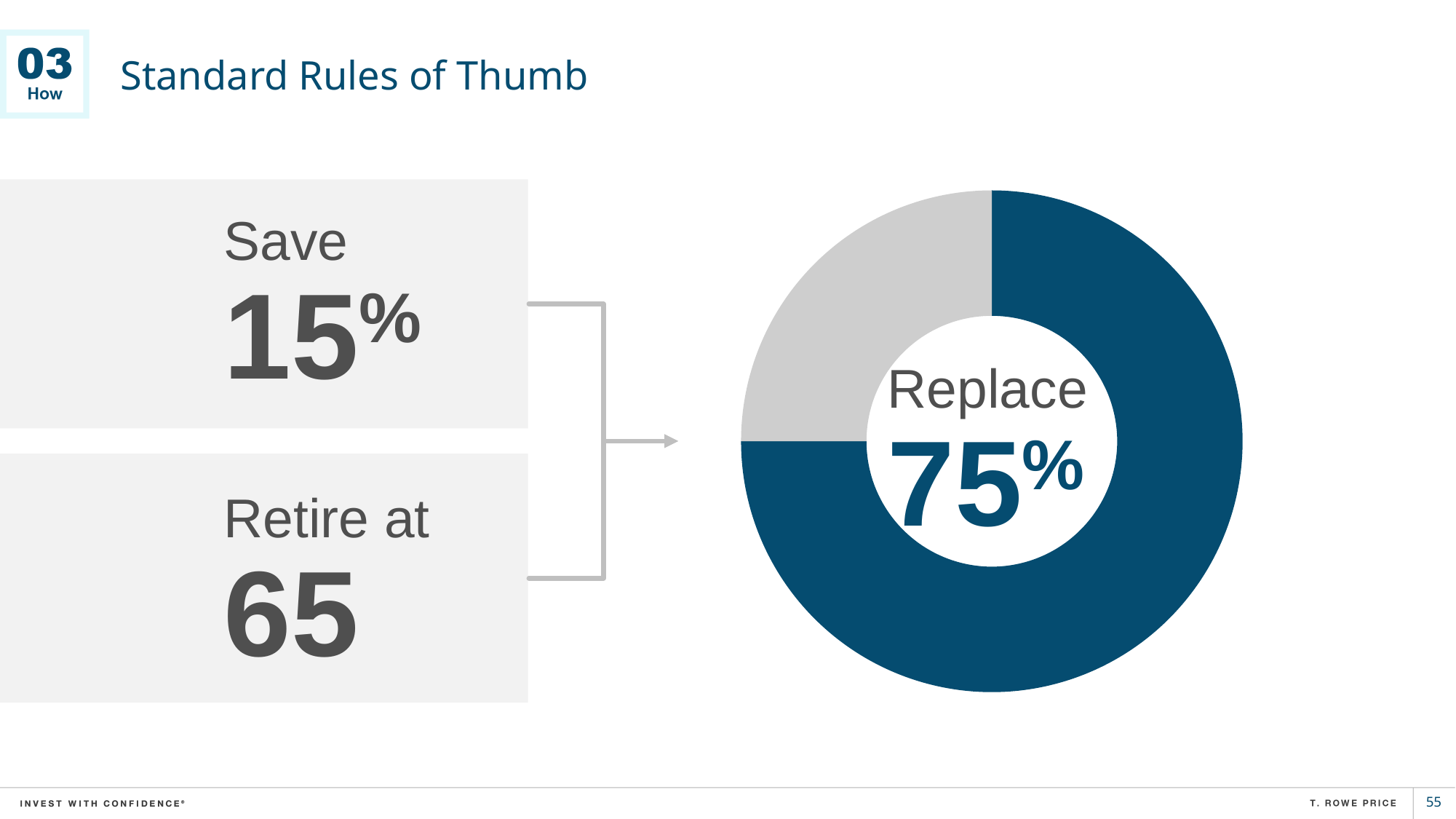
What colour is the smaller segment of the donut chart? grey What percentage is printed in the centre of the donut chart? 75% Is the dark blue segment of the donut chart greater or less than 50% of the whole? greater What share of the donut chart does the dark blue segment represent? 75% Which segment of the donut chart is larger, the dark blue one or the grey one? the dark blue one What kind of chart is shown on the slide? donut (pie) chart How many segments does the donut chart have? 2 What word is printed above the percentage in the centre of the donut chart? Replace What is the title of the slide containing the donut chart? Standard Rules of Thumb